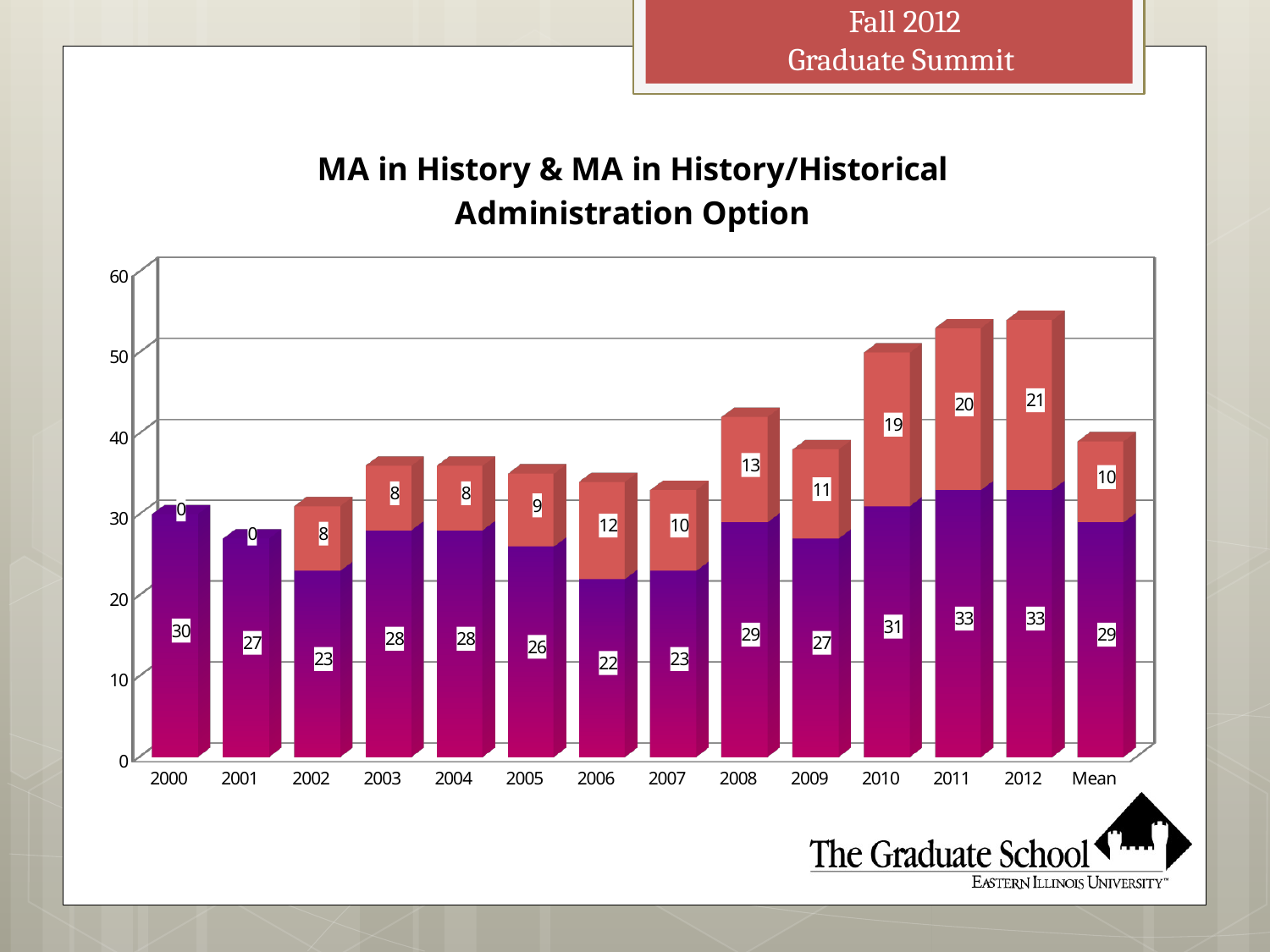
What is the value of the upper (red) segment for 2008? 13 What is the title of the chart? MA in History & MA in History/Historical Administration Option What is the total of the stacked bar for 2012? 54 Which year has the smallest lower (purple) segment? 2006 What kind of chart is shown on the slide? Stacked bar chart What is the value of the upper (red) segment for the Mean bar? 10 What is the value of the lower (purple) segment for 2010? 31 How many categories are shown along the x axis of the chart? 14 Which year has the largest upper (red) segment? 2012 What is the difference between the lower (purple) segment values for 2011 and 2006? 11 Which year has the larger upper (red) segment, 2009 or 2010? 2010 What is the total of the stacked bar for 2010? 50